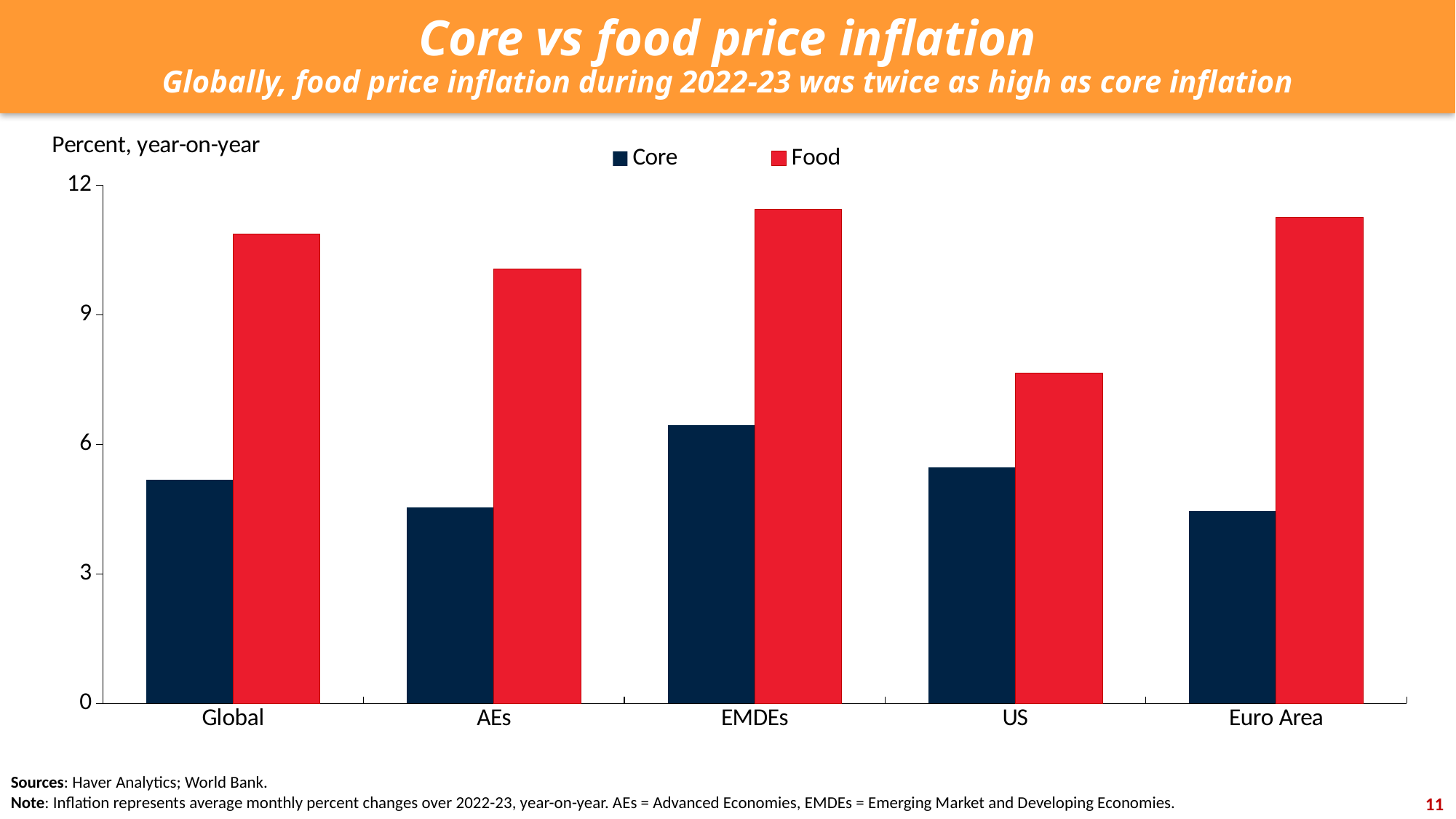
What unit is shown on the y axis label? Percent, year-on-year Is the Core value for EMDEs greater or less than 6? greater How many categories are shown on the x axis? 5 For the US, which is larger, the Core value or the Food value? Food Is the Food value for Global greater or less than 9? greater What kind of chart is shown on the slide? bar chart Is the Food value for Euro Area greater or less than 9? greater Which category has the lowest Food inflation value? US How many series does the legend list? 2 Which category has the highest Core inflation value? EMDEs